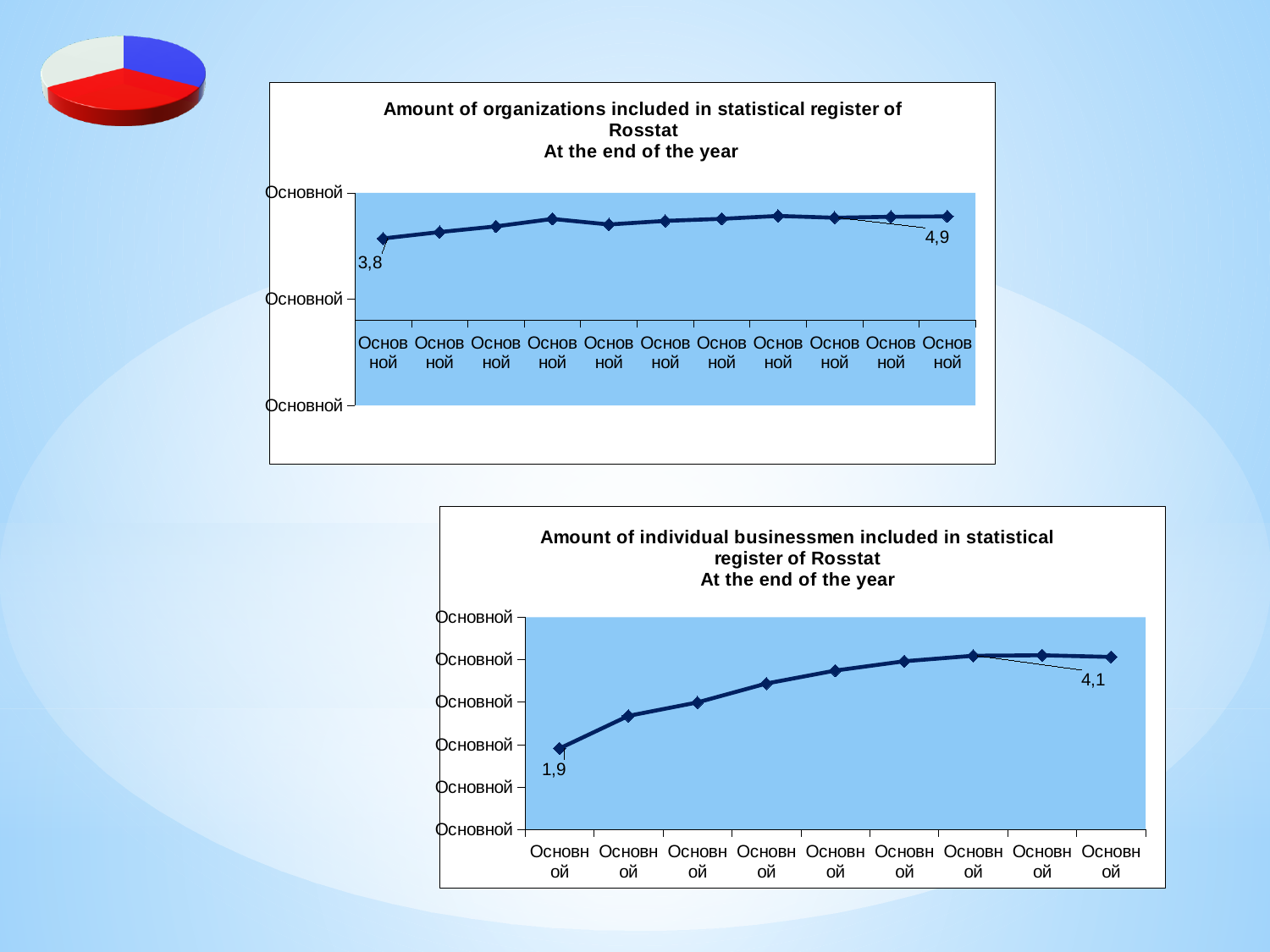
In the top chart, 'Amount of organizations included in statistical register of Rosstat', which is larger: the first labelled value or the last labelled value? the last labelled value How many data points are plotted in the top chart, 'Amount of organizations included in statistical register of Rosstat'? 11 In the top chart, 'Amount of organizations included in statistical register of Rosstat', what is the difference between the last labelled value and the first labelled value? 1,1 In the bottom chart, 'Amount of individual businessmen included in statistical register of Rosstat', what value is labelled on the last data point? 4,1 What type of chart is the top chart, 'Amount of organizations included in statistical register of Rosstat'? line chart In the top chart, 'Amount of organizations included in statistical register of Rosstat', what value is labelled on the last data point? 4,9 In the bottom chart, 'Amount of individual businessmen included in statistical register of Rosstat', do the values generally rise or fall from left to right? rise In the top chart, 'Amount of organizations included in statistical register of Rosstat', what value is labelled on the first data point? 3,8 What type of chart is the bottom chart, 'Amount of individual businessmen included in statistical register of Rosstat'? line chart In the bottom chart, 'Amount of individual businessmen included in statistical register of Rosstat', what is the difference between the last labelled value and the first labelled value? 2,2 How many data points are plotted in the bottom chart, 'Amount of individual businessmen included in statistical register of Rosstat'? 9 In the bottom chart, 'Amount of individual businessmen included in statistical register of Rosstat', what value is labelled on the first data point? 1,9